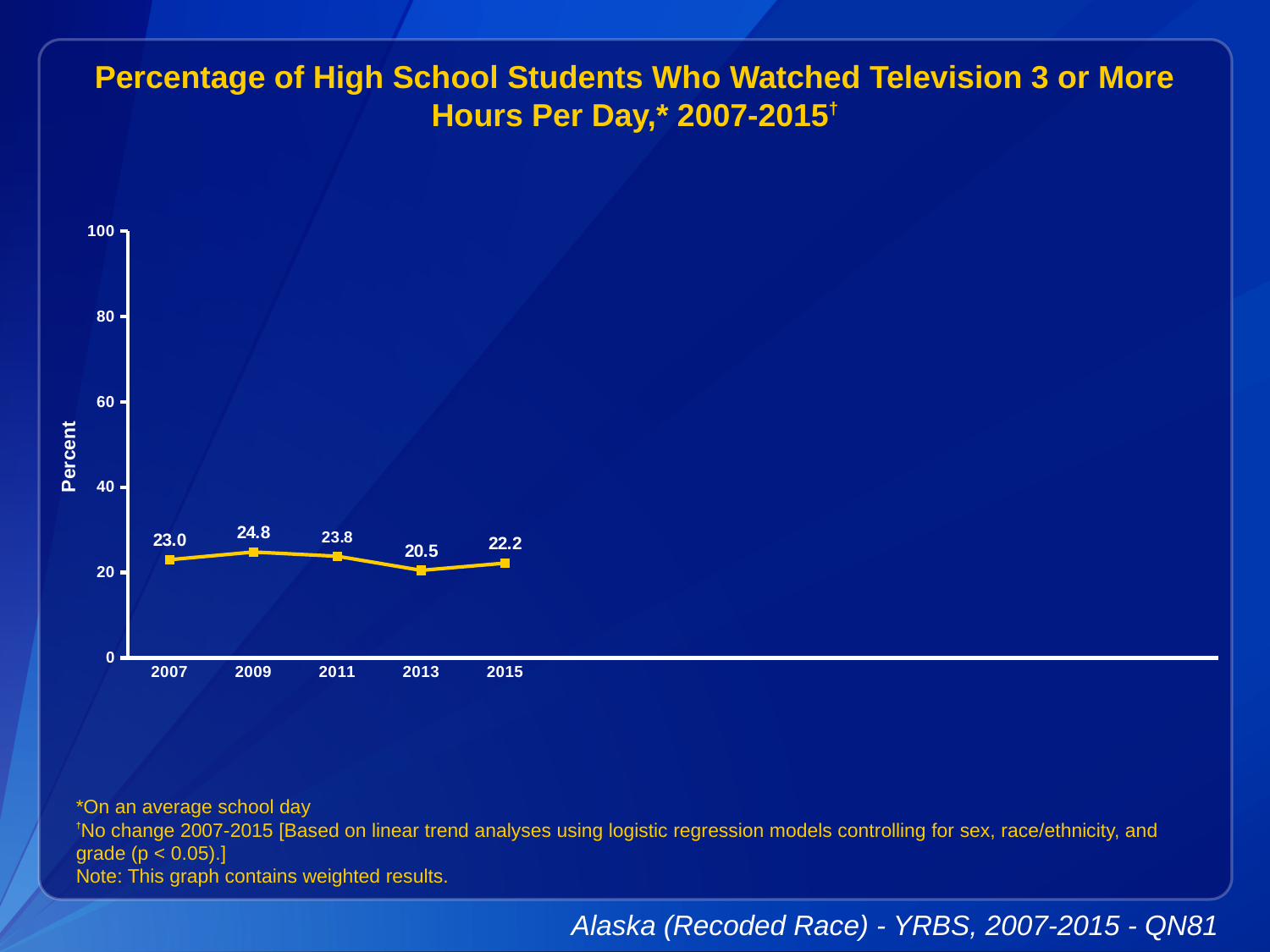
How many years are plotted on the chart? 5 Which year has a larger value, 2011 or 2015? 2011 Which year has the highest percentage? 2009 What is the value plotted for 2013? 20.5 What is the value plotted for 2015? 22.2 What percentage of high school students watched television 3 or more hours per day in 2007? 23.0 Is the value for 2009 greater or less than 40? less Which year has the lowest percentage? 2013 What is the label on the vertical axis? Percent Does the value rise or fall from 2013 to 2015? rise What is the difference between the 2009 value and the 2013 value? 4.3 What kind of chart is shown on the slide? line chart